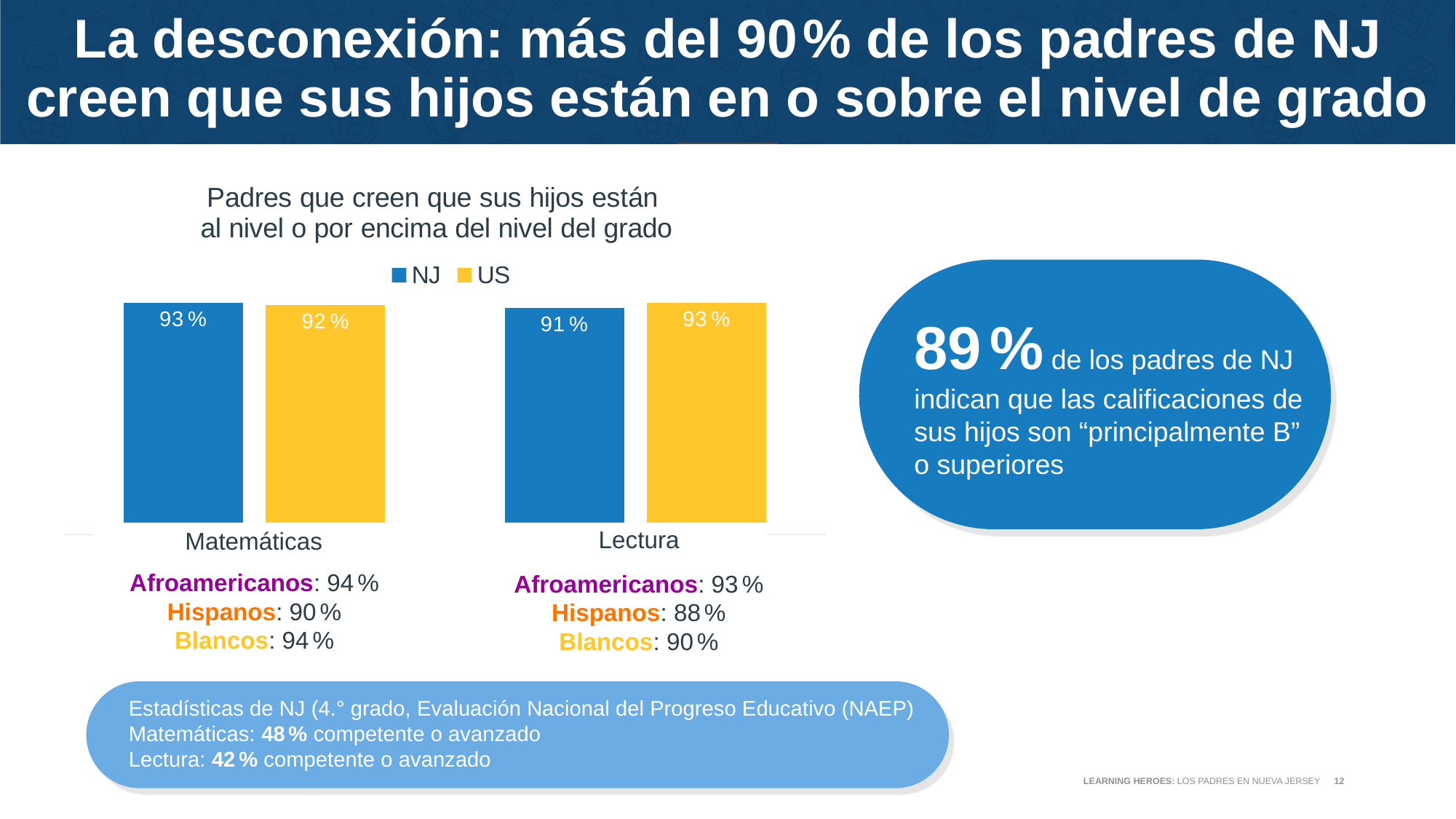
For Matemáticas, which is larger, the NJ value or the US value? NJ What is the difference between the US and NJ values for Lectura? 2 percentage points How many subject categories are shown on the x axis of the chart? 2 How many series does the chart legend list? 2 Which subject has the lower NJ value? Lectura What is the difference between the NJ and US values for Matemáticas? 1 percentage point For Lectura, which is larger, the NJ value or the US value? US What percentage of NJ parents believe their children are at or above grade level in Matemáticas? 93 % What type of chart is shown on the slide? Bar chart What is the US value for Matemáticas in the chart? 92 % What is the NJ value for Lectura in the chart? 91 % What is the US value for Lectura in the chart? 93 %